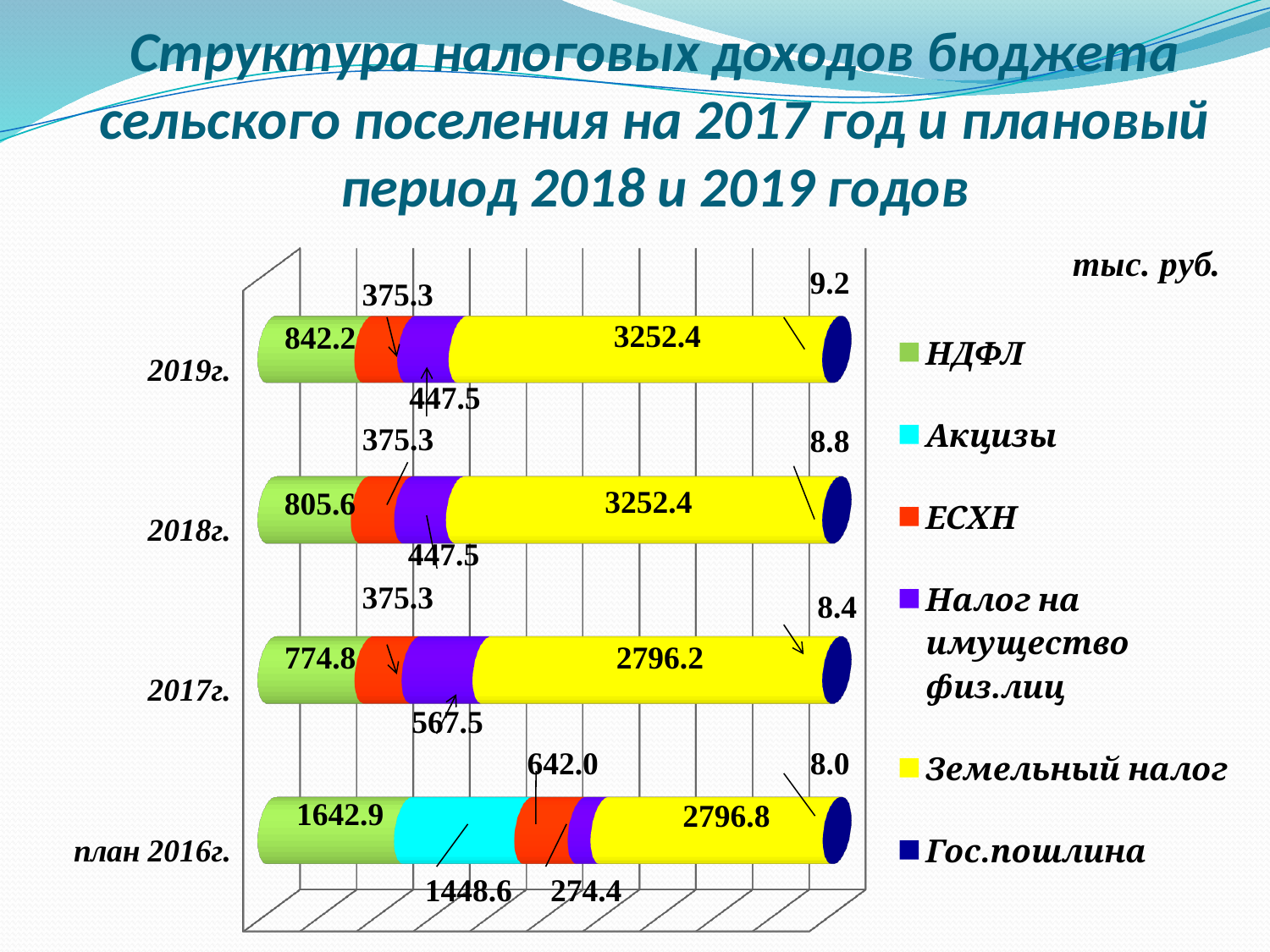
Which is larger: Земельный налог for 2017г. or for план 2016г.? план 2016г. Which year has the lowest value for Гос.пошлина? план 2016г. Which year has the highest value for НДФЛ? план 2016г. What is the difference between the НДФЛ values for 2019г. and 2018г.? 36.6 What is the value of НДФЛ for план 2016г.? 1642.9 How many years (categories) are shown on the chart? 4 What is the value of Акцизы for план 2016г.? 1448.6 What is the value of Земельный налог for 2019г.? 3252.4 What is the value of Налог на имущество физ.лиц for 2017г.? 567.5 What type of chart is shown on the slide? Stacked bar chart What is the value of Гос.пошлина for 2018г.? 8.8 How many series does the legend list? 6